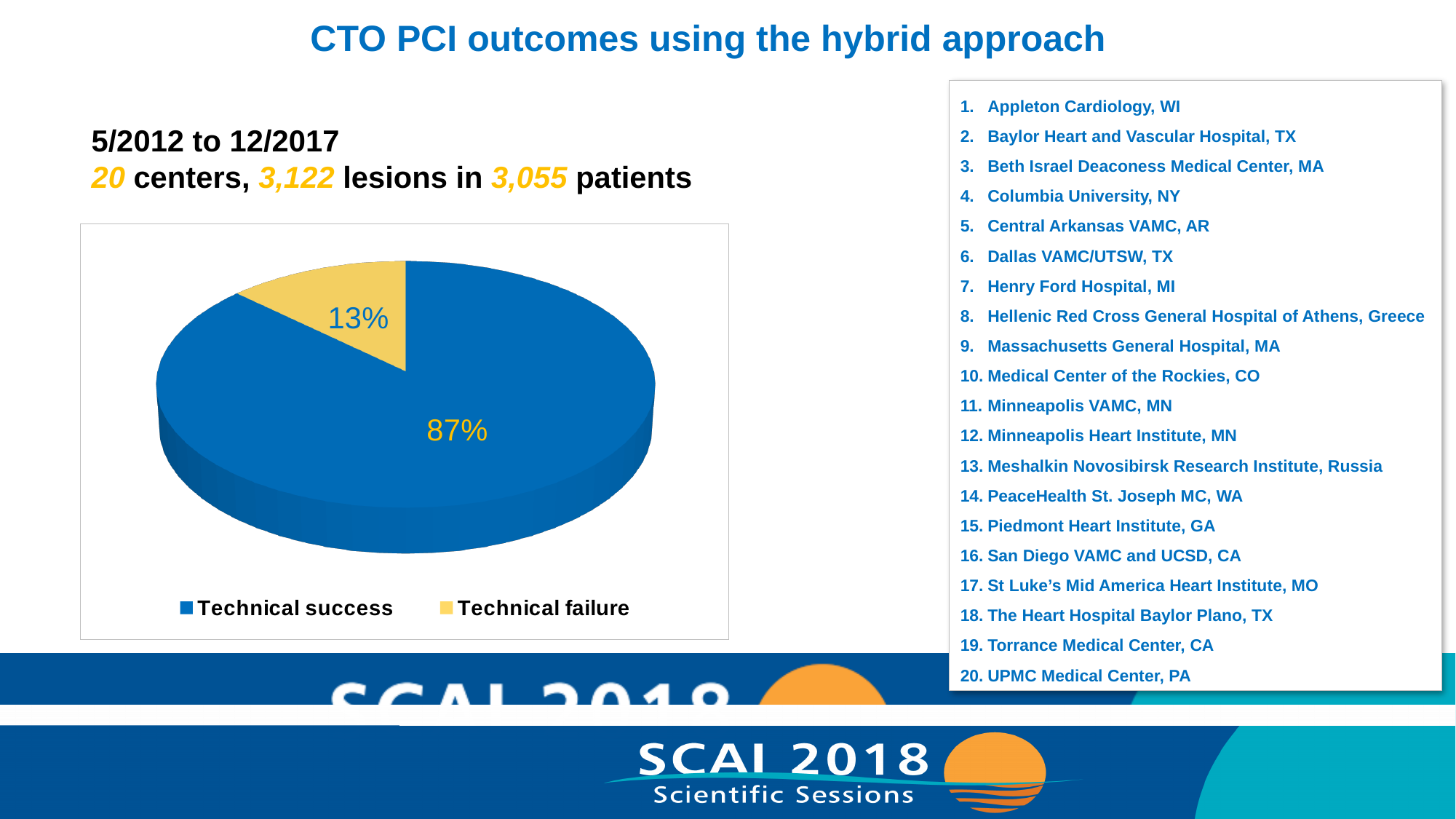
How many slices does the pie chart have? 2 Which is larger, Technical success or Technical failure? Technical success How many entries does the legend list? 2 What is the difference in percentage points between Technical success and Technical failure? 74 What share of the pie is Technical success? 87% What share of the pie is Technical failure? 13% Which slice of the pie is the largest? Technical success What colour is the Technical failure slice? yellow What colour is the Technical success slice? blue What kind of chart is shown on the slide? pie chart Which slice of the pie is the smallest? Technical failure